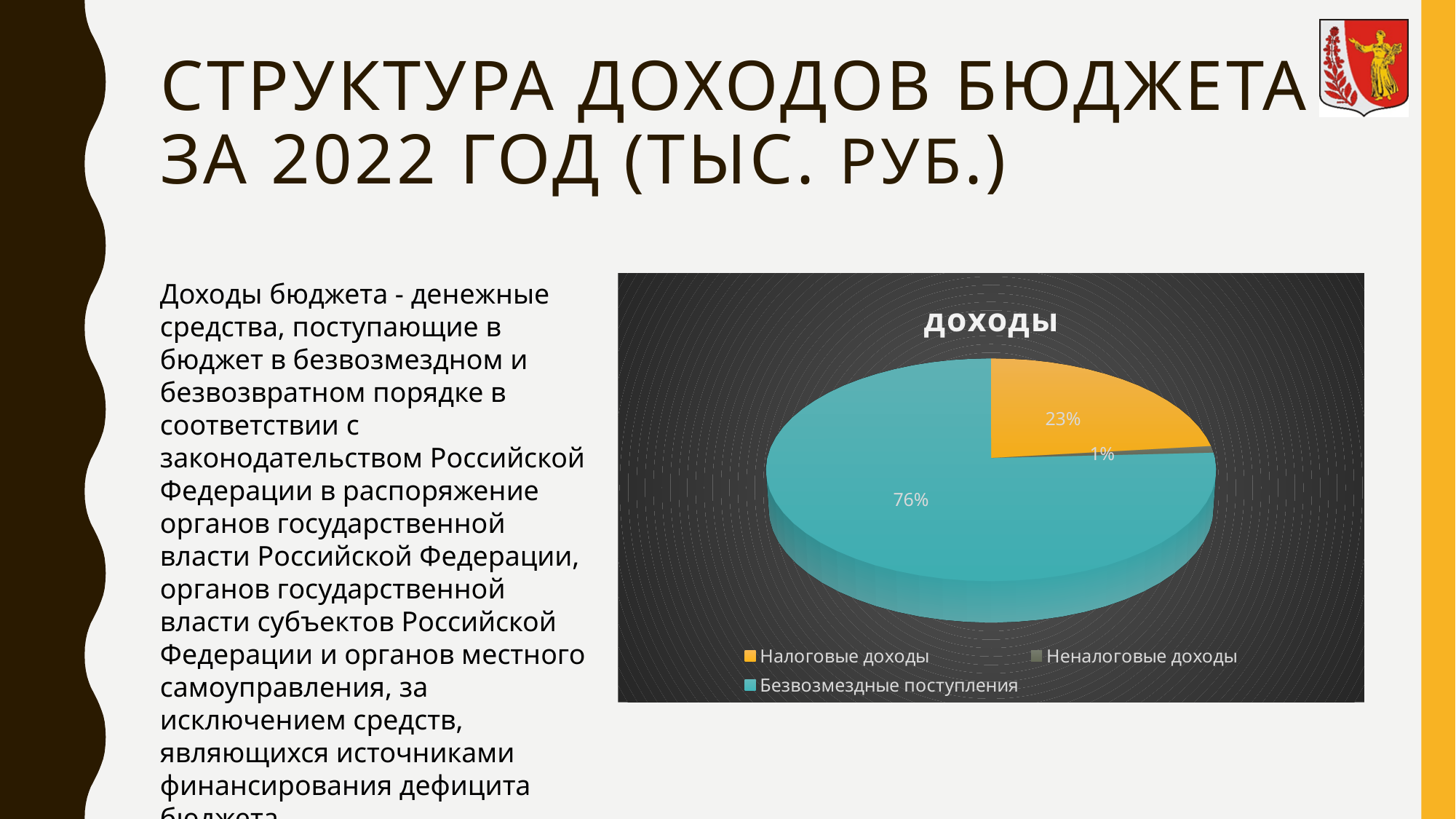
What share of the pie does Неналоговые доходы take? 1% What share of the pie does Налоговые доходы take? 23% What is the difference in percentage points between Безвозмездные поступления and Налоговые доходы? 53 What kind of chart is shown on the slide? pie chart Which category has the smallest slice of the pie? Неналоговые доходы What is the title of the chart? доходы What share of the pie does Безвозмездные поступления take? 76% How many entries does the legend list? 3 Which is larger, the share for Налоговые доходы or the share for Неналоговые доходы? Налоговые доходы Which category has the largest slice of the pie? Безвозмездные поступления How many slices does the pie chart have? 3 What colour is the slice for Налоговые доходы? orange